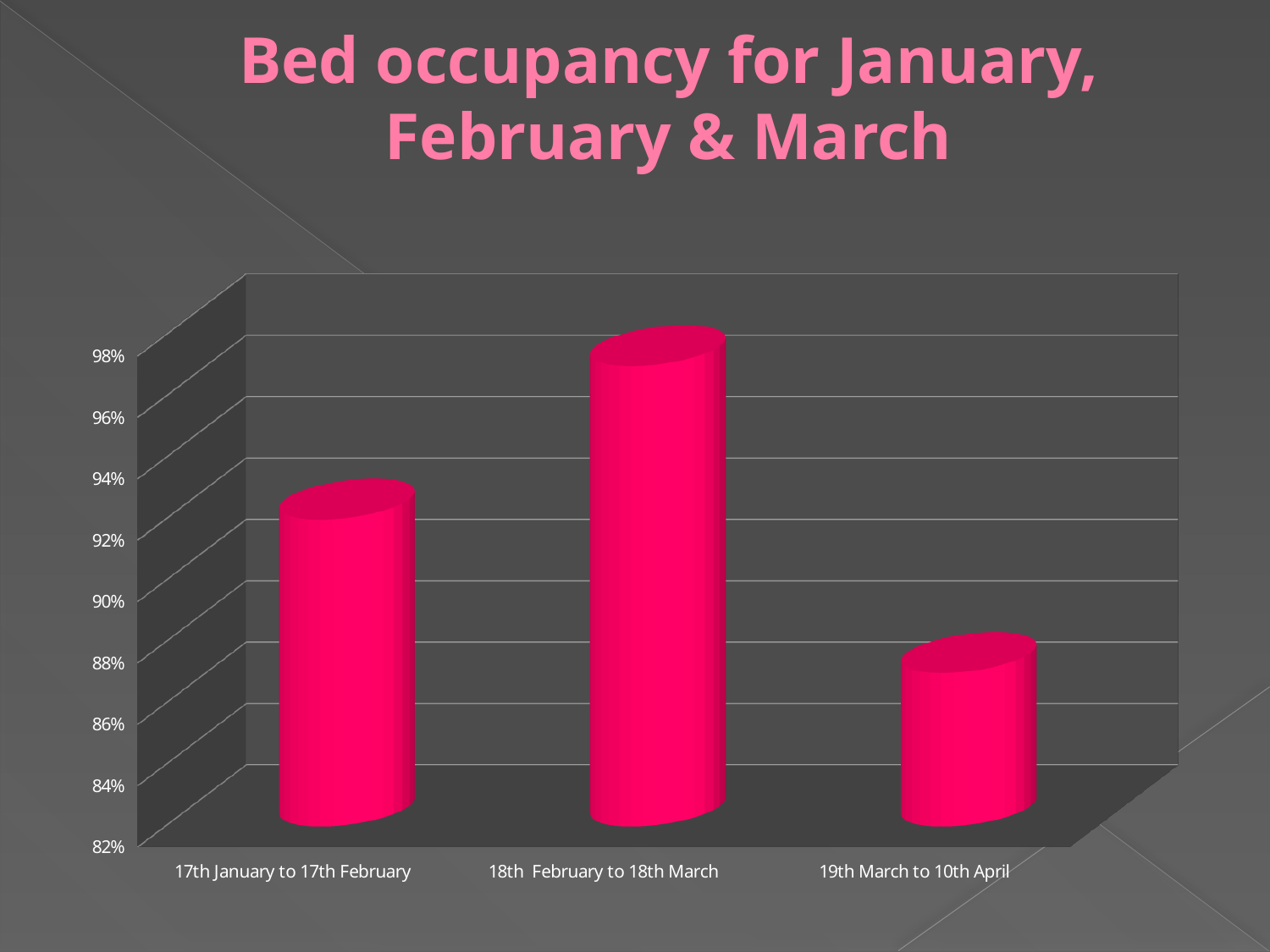
Is the value for 18th February to 18th March greater or less than 96%? greater Is the value for 19th March to 10th April greater or less than 84%? greater Which period has the lowest bed occupancy? 19th March to 10th April Is the value for 17th January to 17th February greater or less than 96%? less What kind of chart is shown on the slide? bar chart Which is larger, the bed occupancy for 17th January to 17th February or for 19th March to 10th April? 17th January to 17th February What is the title of the chart? Bed occupancy for January, February & March How many categories are plotted on the chart? 3 Which period has the highest bed occupancy? 18th February to 18th March Do the values rise or fall from the second period to the third period along the x axis? fall